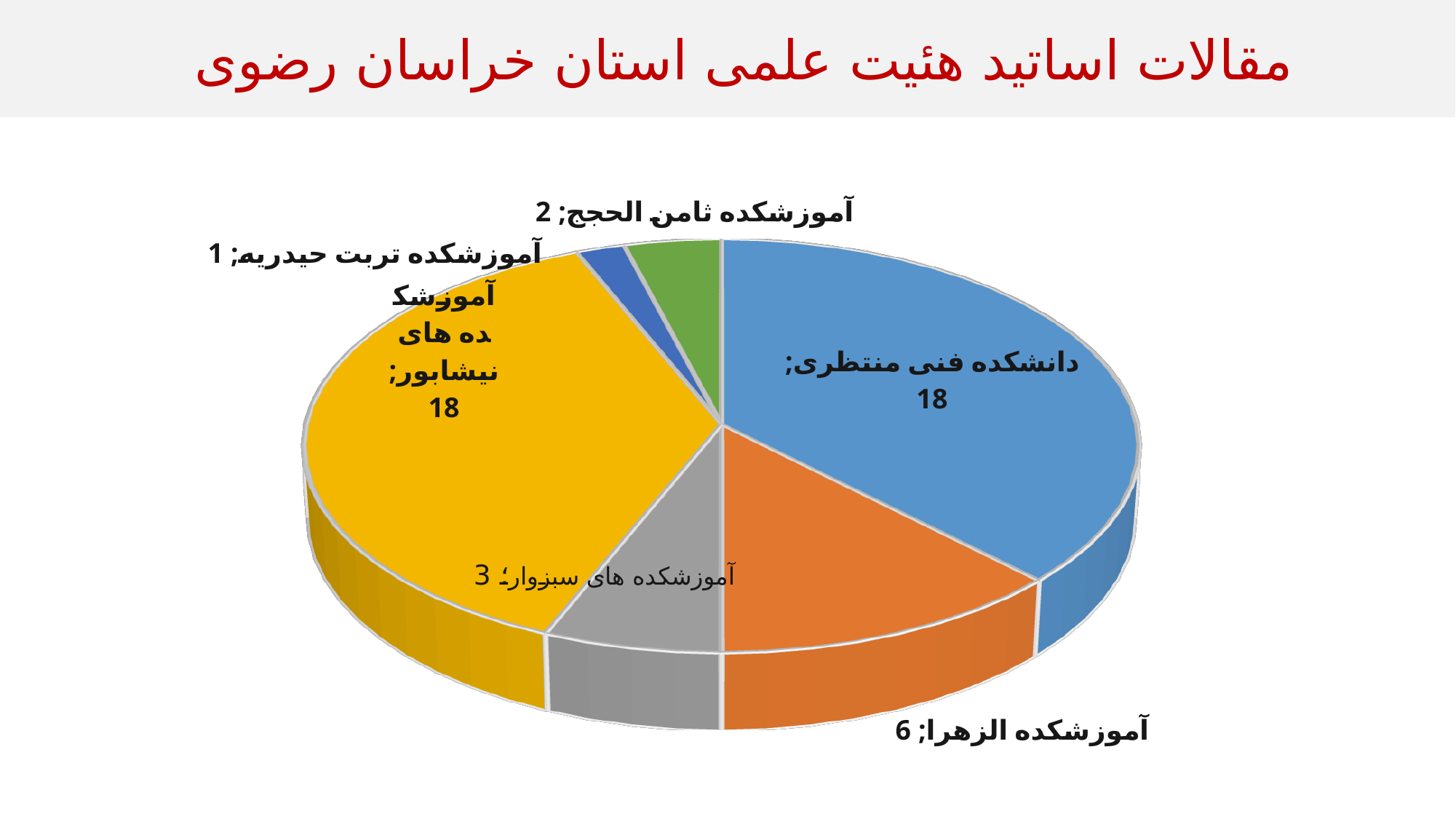
What is the value for دانشکده فنی منتظری? 18 What is the title of the slide? مقالات اساتید هئیت علمی استان خراسان رضوی Which is larger, آموزشکده الزهرا or آموزشکده های سبزوار? آموزشکده الزهرا What is the value for آموزشکده ثامن الحجج? 2 What type of chart is shown on the slide? pie chart Which category has the smallest slice? آموزشکده تربت حیدریه What share of the pie does دانشکده فنی منتظری represent? 37.5% What is the total of all slices in the pie chart? 48 How many slices does the pie chart have? 6 What is the value for آموزشکده الزهرا? 6 What is the difference between the values for آموزشکده های نیشابور and آموزشکده الزهرا? 12 What is the value for آموزشکده های سبزوار? 3